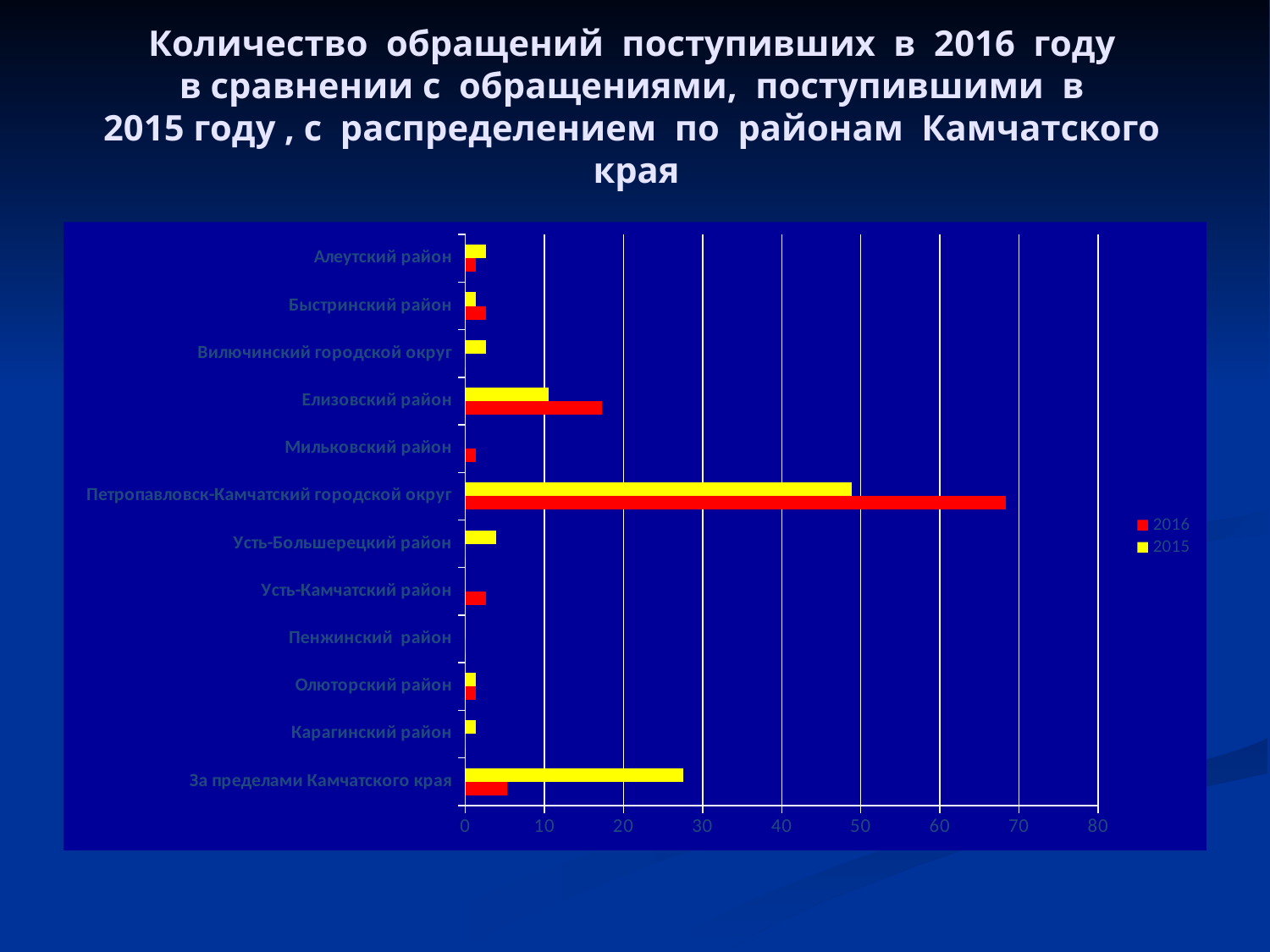
Which category has the highest value for 2016? Петропавловск-Камчатский городской округ Which category has the highest value for 2015? Петропавловск-Камчатский городской округ For За пределами Камчатского края, which year has the larger value, 2015 or 2016? 2015 What kind of chart is shown on the slide? bar chart How many categories (districts) are shown on the chart? 12 Is the 2015 value for За пределами Камчатского края greater or less than 20? greater How many series does the legend list? 2 Which colour represents the 2016 series in the legend? red Is the 2016 value for Петропавловск-Камчатский городской округ greater or less than 60? greater Is the 2016 value for Елизовский район greater or less than 10? greater For Елизовский район, which year has the larger value, 2015 or 2016? 2016